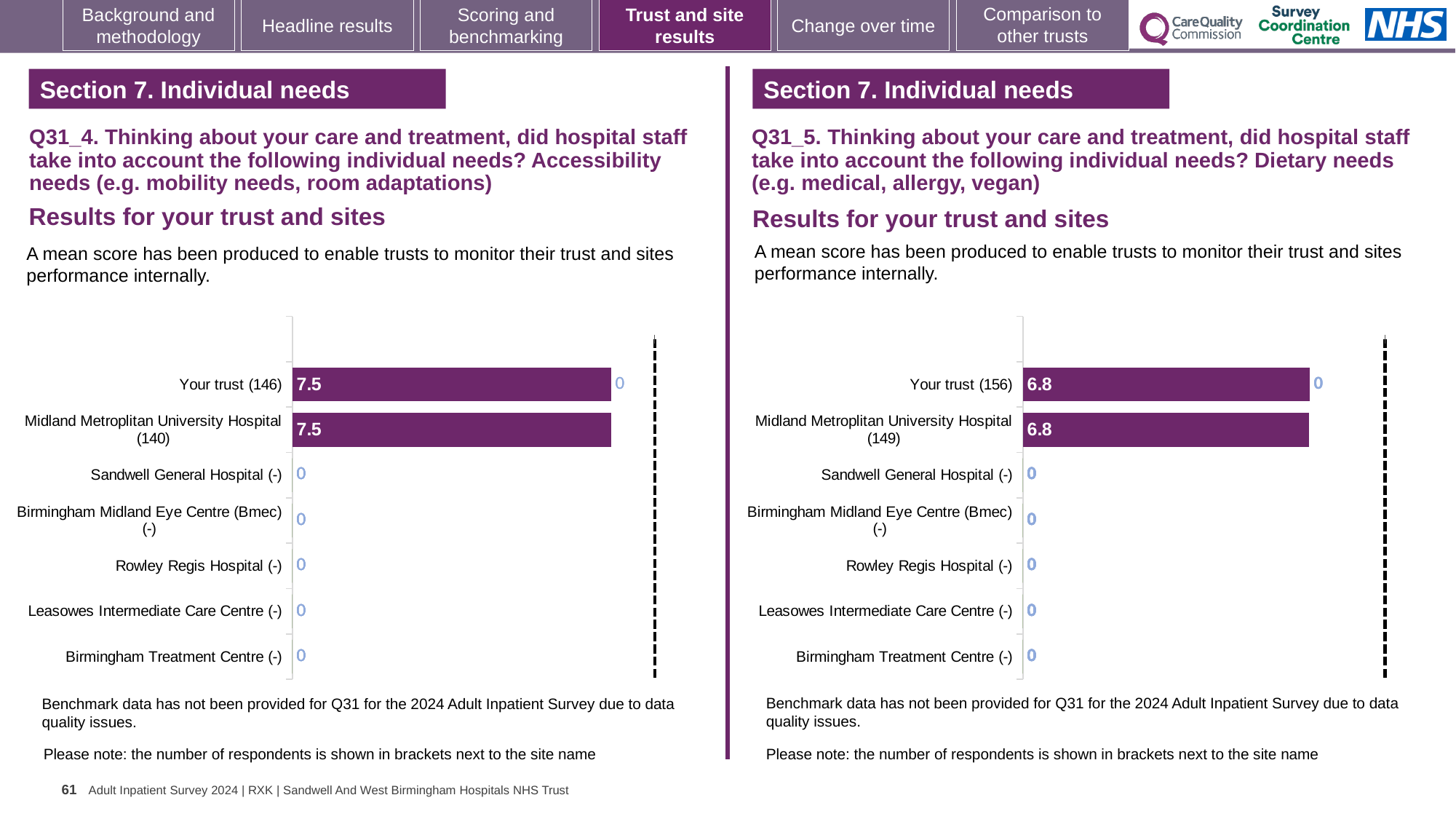
In the Q31_5 Dietary needs chart on the right, what is the mean score for Your trust (156)? 6.8 In the Q31_4 Accessibility needs chart on the left, what is the mean score for Midland Metroplitan University Hospital (140)? 7.5 What kind of chart is used in the Q31_4 Accessibility needs chart on the left? Bar chart In the Q31_5 Dietary needs chart on the right, how many respondents are shown in brackets for Midland Metroplitan University Hospital? 149 How many sites or categories are listed in the Q31_5 Dietary needs chart on the right? 7 In the Q31_4 Accessibility needs chart on the left, what is the mean score for Your trust (146)? 7.5 In the Q31_4 Accessibility needs chart on the left, what value is shown for Sandwell General Hospital (-)? 0 Is the mean score for Your trust higher in the Q31_4 Accessibility needs chart on the left or in the Q31_5 Dietary needs chart on the right? Q31_4 Accessibility needs (left) In the Q31_4 Accessibility needs chart on the left, how many respondents are shown in brackets for Your trust? 146 What is the difference between the Your trust mean score in the Q31_4 chart on the left (7.5) and the Your trust mean score in the Q31_5 chart on the right (6.8)? 0.7 How many sites or categories are listed in the Q31_4 Accessibility needs chart on the left? 7 In the Q31_5 Dietary needs chart on the right, what is the mean score for Midland Metroplitan University Hospital (149)? 6.8